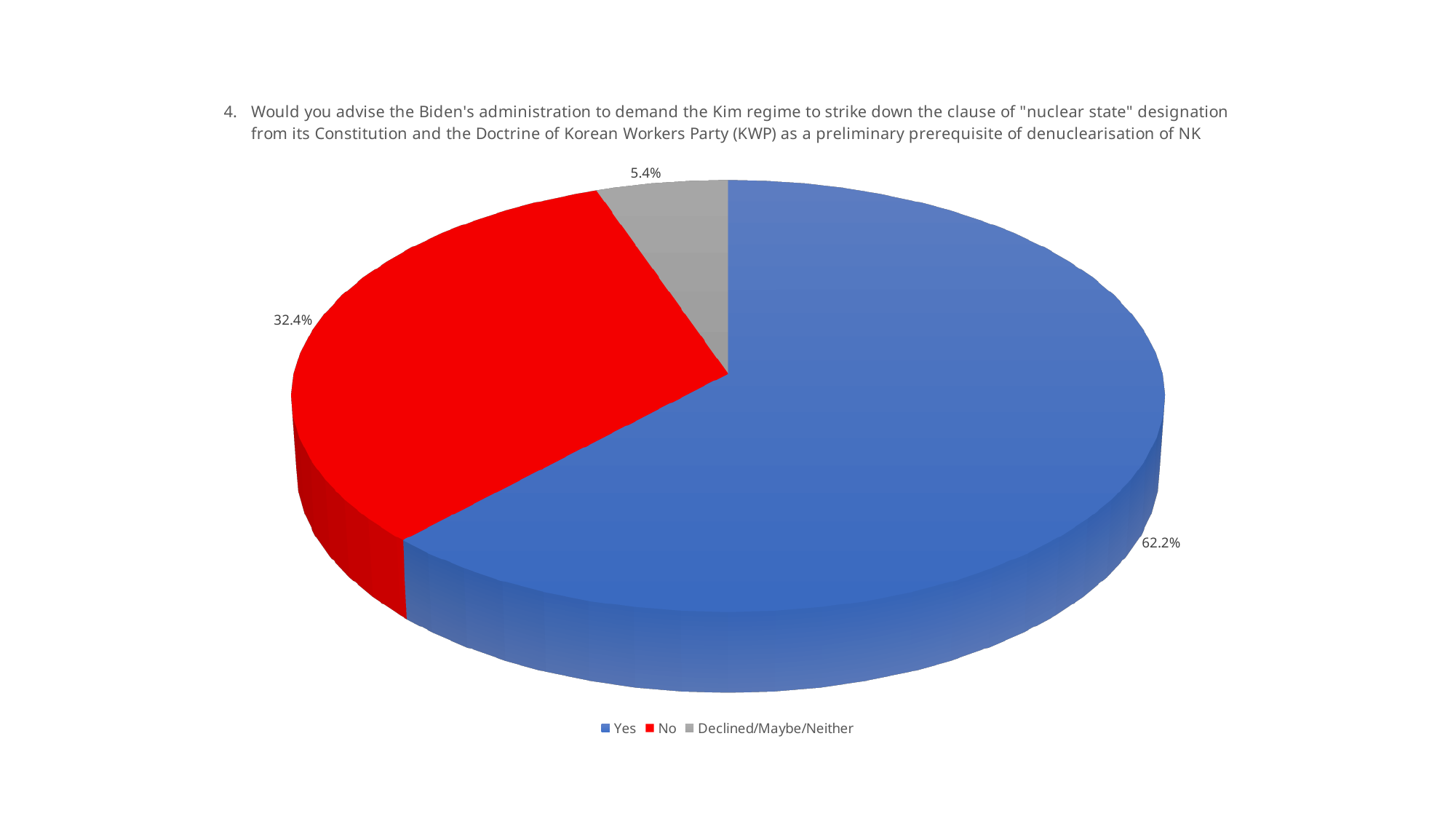
What percentage of respondents answered No? 32.4% How many categories does the pie chart show? 3 What percentage of respondents answered Yes? 62.2% What is the difference in percentage points between the Yes and No shares? 29.8 What kind of chart is shown on the slide? Pie chart What colour is the No slice of the pie? Red Which is larger, the share for No or the share for Declined/Maybe/Neither? No What colour is the Yes slice of the pie? Blue Which response category has the smallest share of the pie? Declined/Maybe/Neither Which response category has the largest share of the pie? Yes What is the combined share of the No and Declined/Maybe/Neither slices? 37.8% What percentage of respondents are in the Declined/Maybe/Neither category? 5.4%